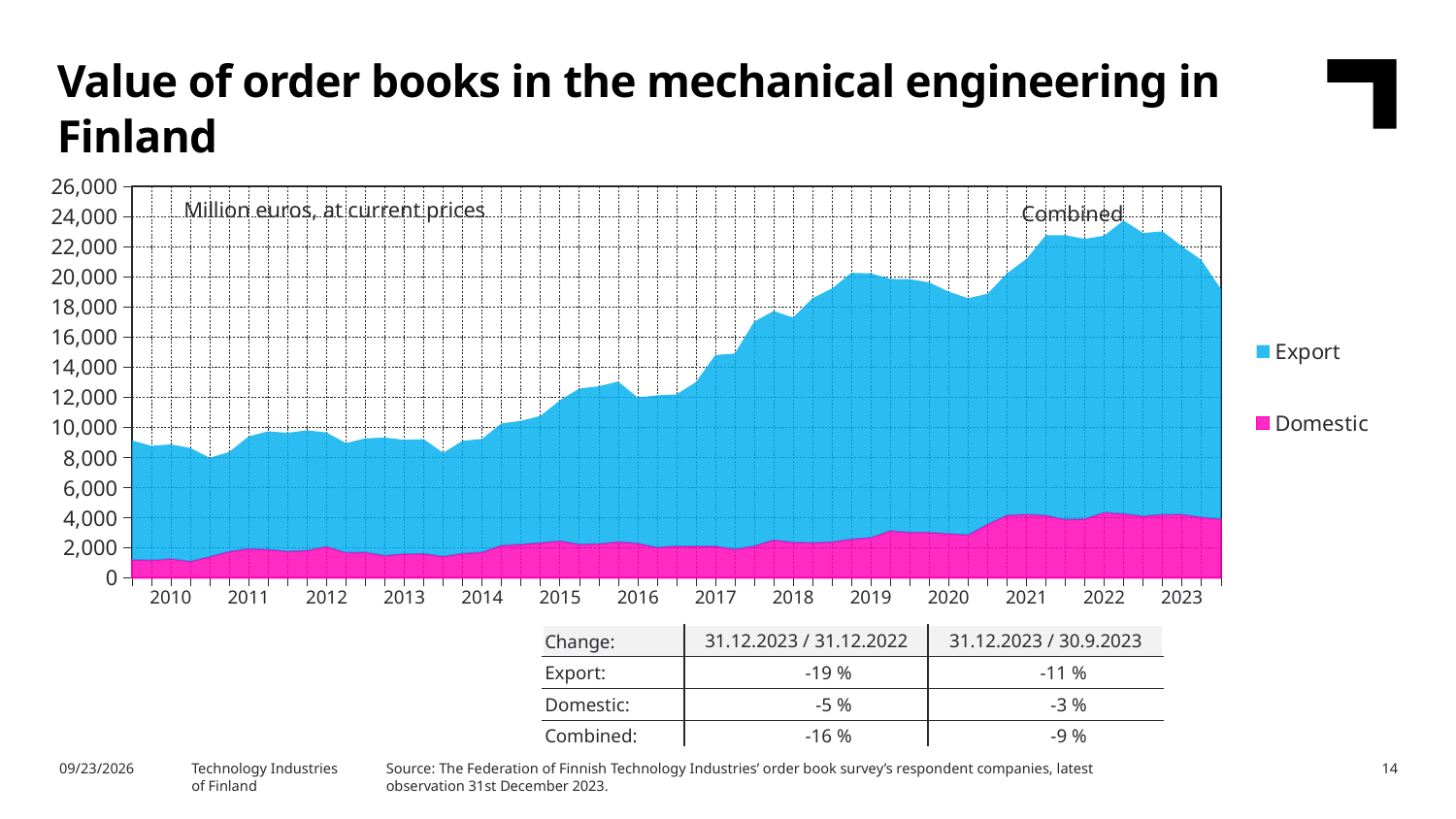
How many year labels appear on the x axis of the chart? 14 Is the combined value of order books at the end of 2023 greater or less than 18,000? greater Is the Domestic value of order books in 2021 greater or less than 3,000? greater What are the two series named in the chart legend? Export and Domestic How many series does the chart legend list? 2 What unit is stated on the chart for the values? Million euros, at current prices Which series, Export or Domestic, has the larger value throughout the chart? Export Is the combined value of order books at the start of 2010 greater or less than 10,000? less What type of chart is shown on the slide? Area chart Does the combined value of order books generally rise or fall from 2010 to 2022? rise